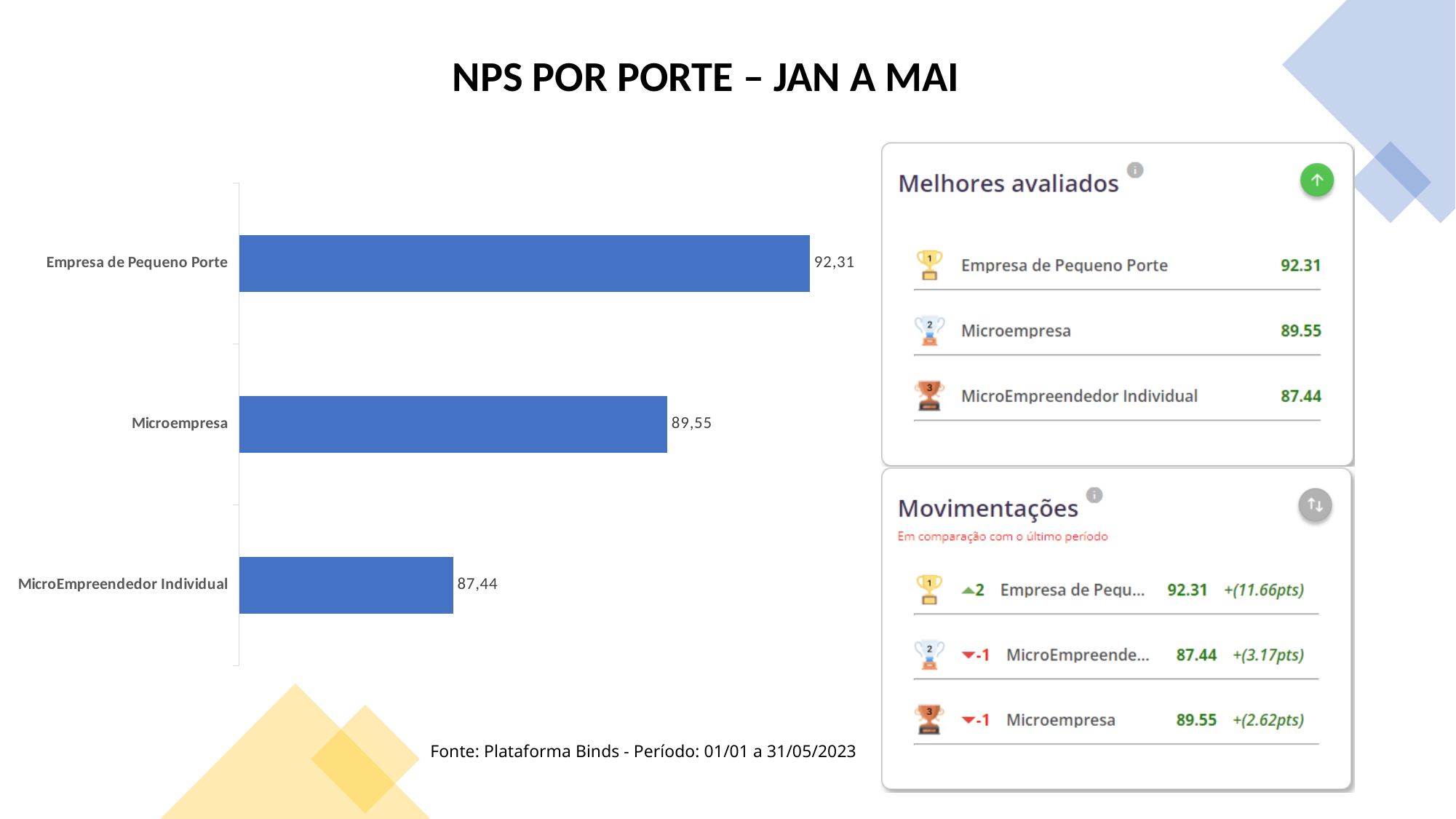
What is the title of the slide's chart? NPS POR PORTE – JAN A MAI What is the NPS value for Microempresa in the bar chart? 89,55 Which category has the lowest NPS in the bar chart? MicroEmpreendedor Individual What is the difference between the NPS of Microempresa and MicroEmpreendedor Individual? 2,11 What kind of chart is shown on the slide? Bar chart What is the difference between the NPS of Empresa de Pequeno Porte and Microempresa? 2,76 Which has a higher NPS, Microempresa or MicroEmpreendedor Individual? Microempresa What is the NPS value for Empresa de Pequeno Porte in the bar chart? 92,31 What is the NPS value for MicroEmpreendedor Individual in the bar chart? 87,44 How many categories are shown in the bar chart? 3 Which category has the highest NPS in the bar chart? Empresa de Pequeno Porte What colour are the bars in the chart? Blue